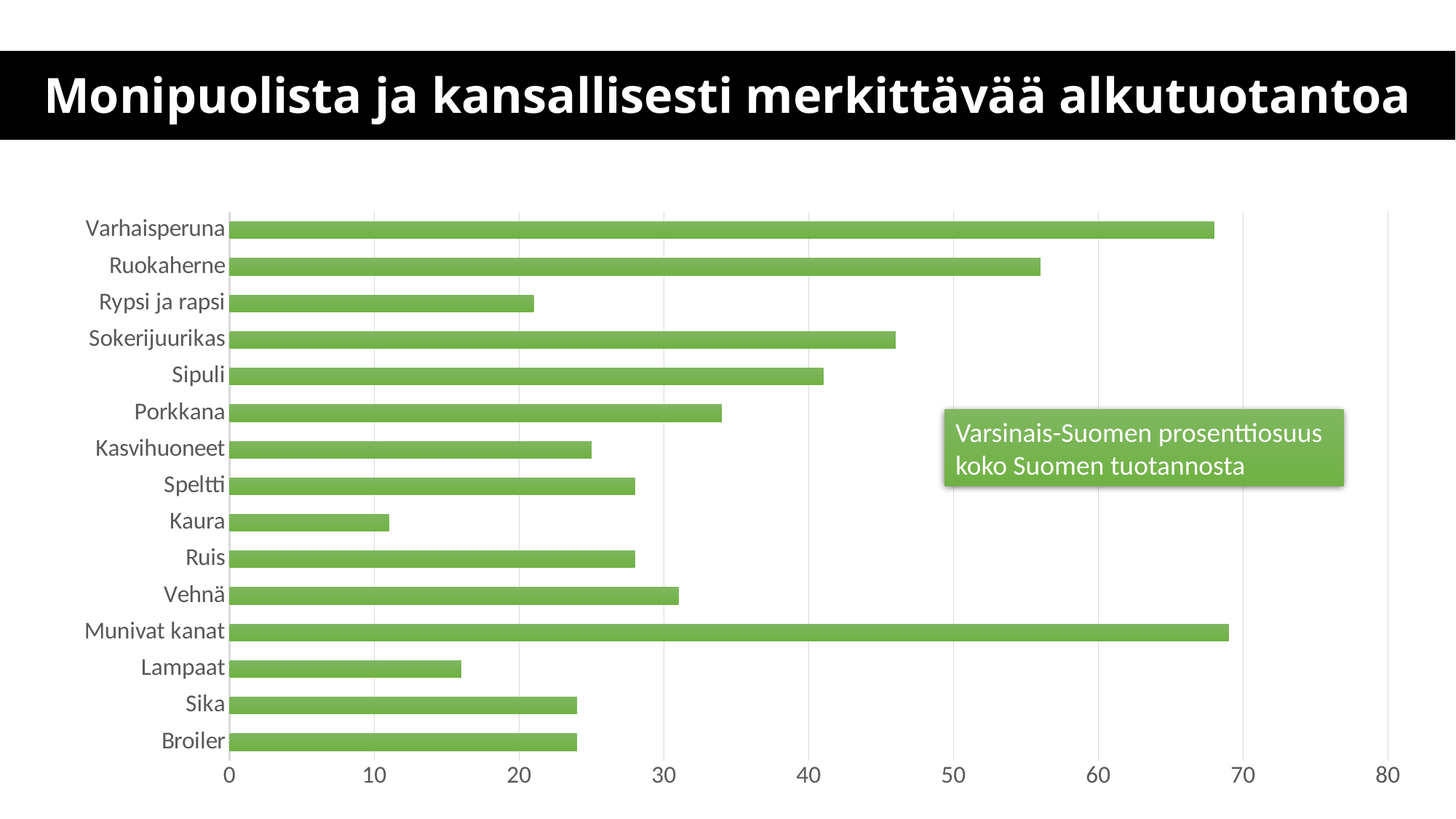
Is the value for Rypsi ja rapsi greater or less than 30? less How many categories are plotted in the chart? 15 Which has the larger value, Vehnä or Kaura? Vehnä Which has the larger value, Lampaat or Sika? Sika Which category has the lowest value in the chart? Kaura Is the value for Kaura greater or less than 20? less Is the value for Porkkana greater or less than 30? greater What does the green text box on the chart say the values represent? Varsinais-Suomen prosenttiosuus koko Suomen tuotannosta What kind of chart is shown on the slide? bar chart Which has the larger value, Ruokaherne or Sokerijuurikas? Ruokaherne